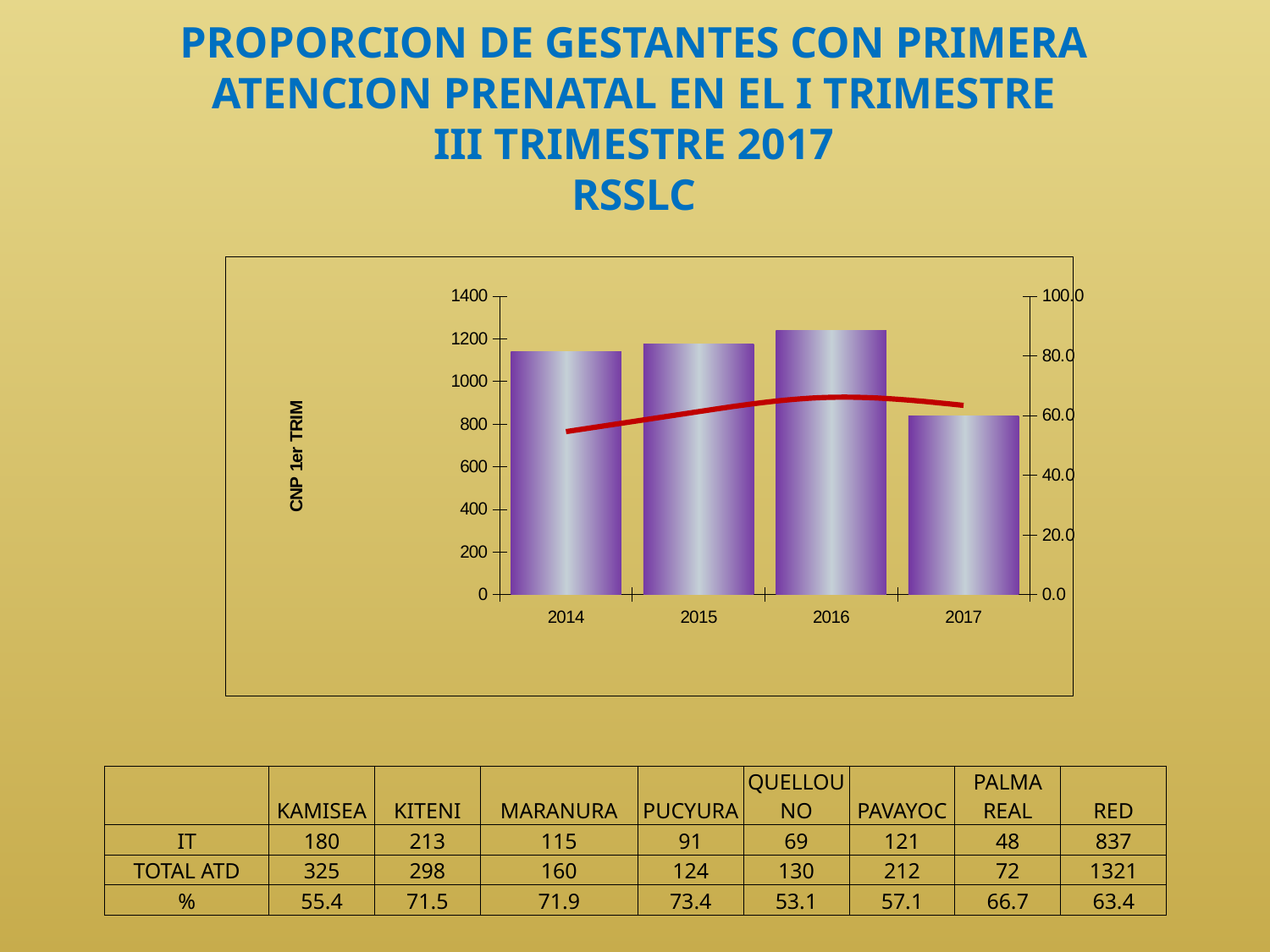
How many years are shown on the x axis of the chart? 4 Which bar is taller, 2016 or 2017? 2016 Does the red line rise or fall from 2016 to 2017? falls Does the red line rise or fall from 2014 to 2016? rises What is the highest tick value shown on the right vertical axis of the chart? 100.0 What is the title of the left vertical axis of the chart? CNP 1er TRIM Is the bar value for 2014 greater or less than 1000? greater Is the bar value for 2017 greater or less than 1000? less What kind of chart is shown on the slide? A bar chart with a line overlaid Which year has the shortest bar in the chart? 2017 Which year has the tallest bar in the chart? 2016 Is the bar value for 2016 greater or less than 1200? greater